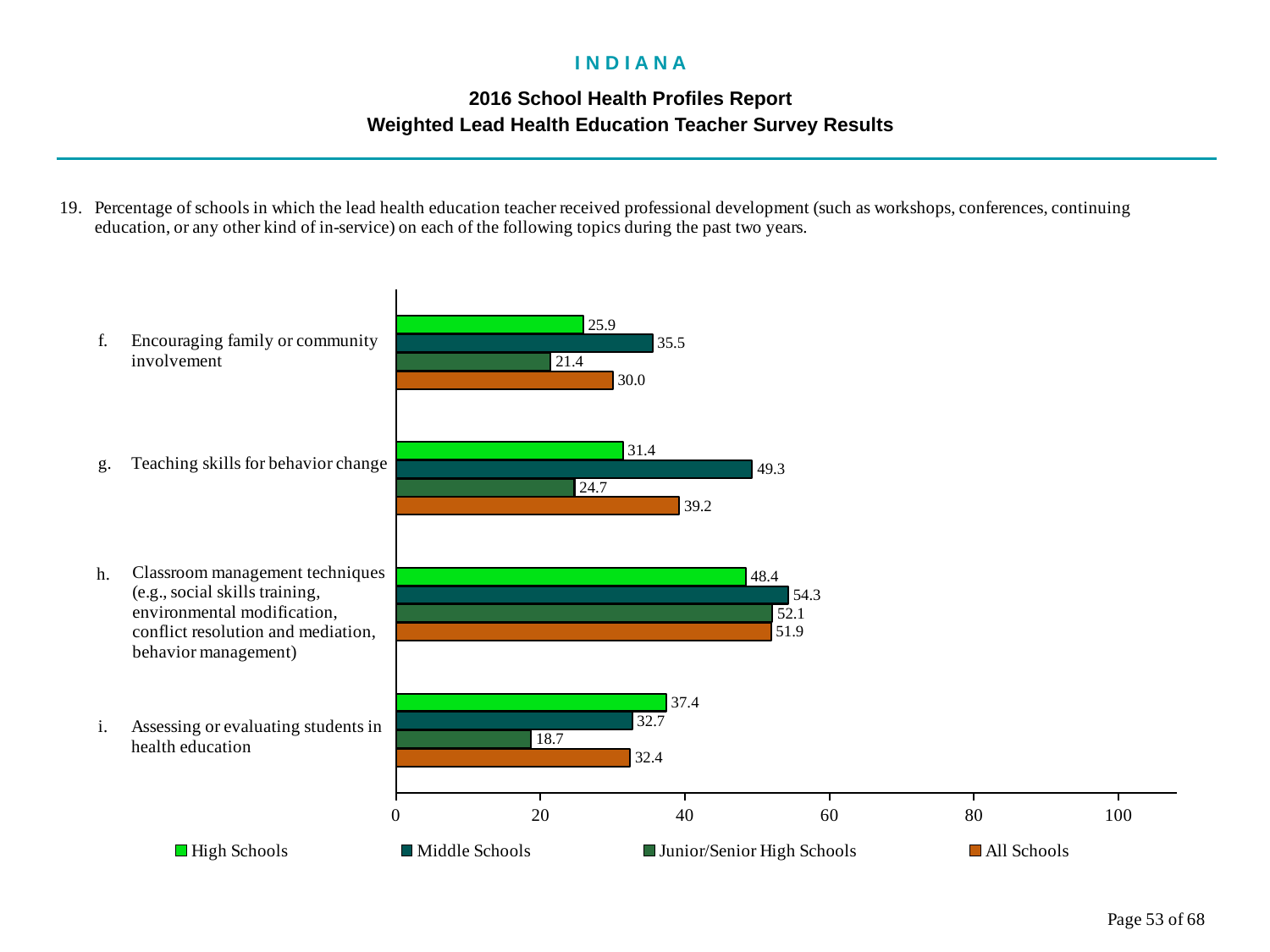
Which topic has the lowest High Schools value? Encouraging family or community involvement Is the Middle Schools value for 'Classroom management techniques' greater or less than 40? greater Which series is shown in orange in the legend? All Schools For 'Assessing or evaluating students in health education', which is larger: the High Schools value or the Middle Schools value? High Schools What is the All Schools value for 'Encouraging family or community involvement'? 30.0 What is the difference between the Middle Schools and High Schools values for 'Teaching skills for behavior change'? 17.9 What is the value for Middle Schools for 'Teaching skills for behavior change'? 49.3 How many series does the legend list? 4 What is the value for Junior/Senior High Schools for 'Assessing or evaluating students in health education'? 18.7 How many topics are shown on the chart? 4 Which topic has the highest Middle Schools value? Classroom management techniques What kind of chart is shown on the slide? Bar chart